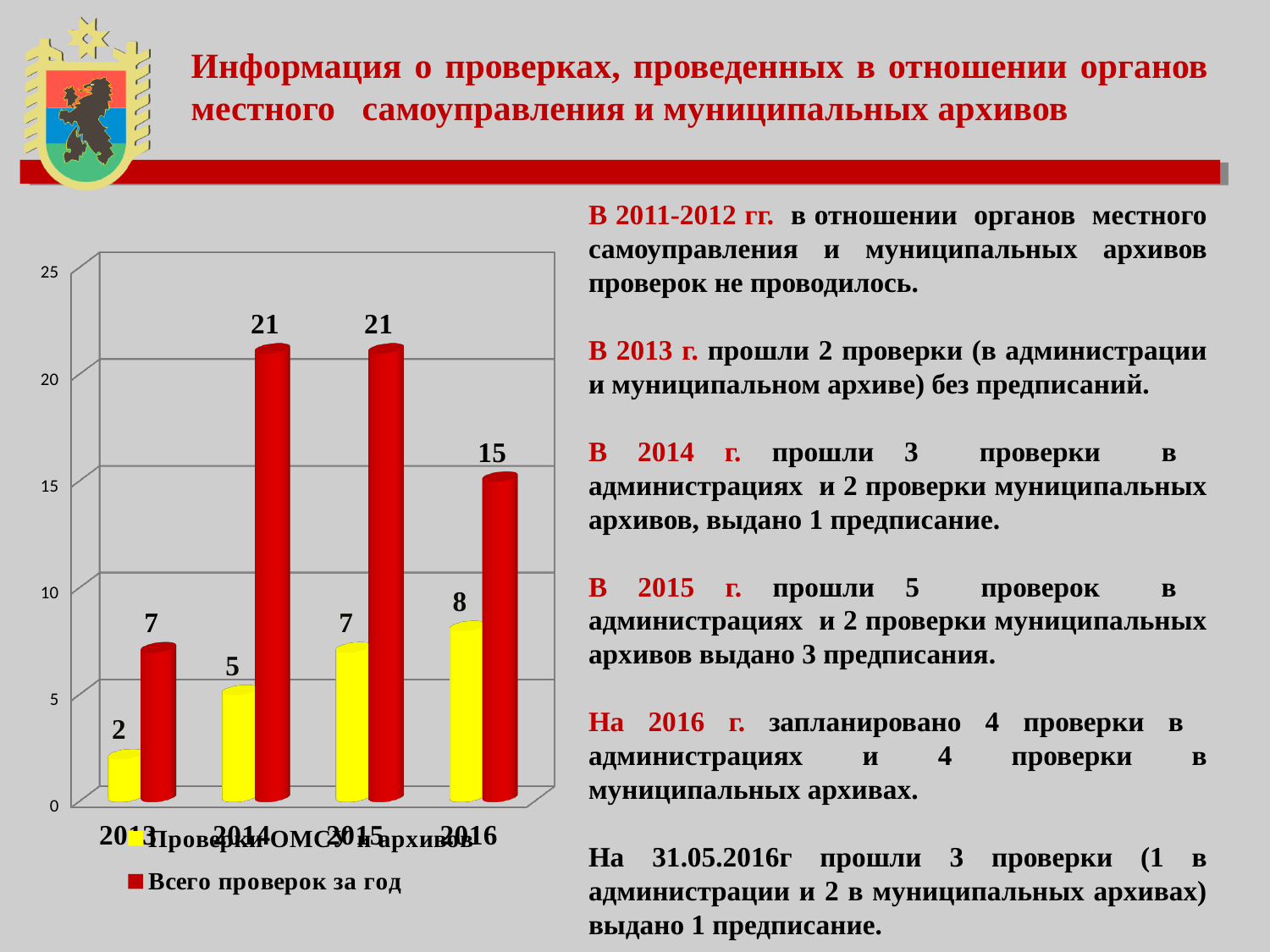
What is the value of "Проверки ОМС и архивов" for 2016? 8 How many years are shown on the x axis of the chart? 4 What is the value of "Проверки ОМС и архивов" for 2013? 2 What kind of chart is shown on the slide? bar chart Which is larger: "Всего проверок за год" in 2014 or in 2016? 2014 In which year is the value of "Проверки ОМС и архивов" the highest? 2016 How many series does the chart legend list? 2 Does the value of "Проверки ОМС и архивов" rise or fall from 2013 to 2016? rise What is the value of "Всего проверок за год" for 2014? 21 What is the value of "Всего проверок за год" for 2016? 15 What is the difference between "Всего проверок за год" and "Проверки ОМС и архивов" in 2015? 14 In which year is the value of "Всего проверок за год" the lowest? 2013